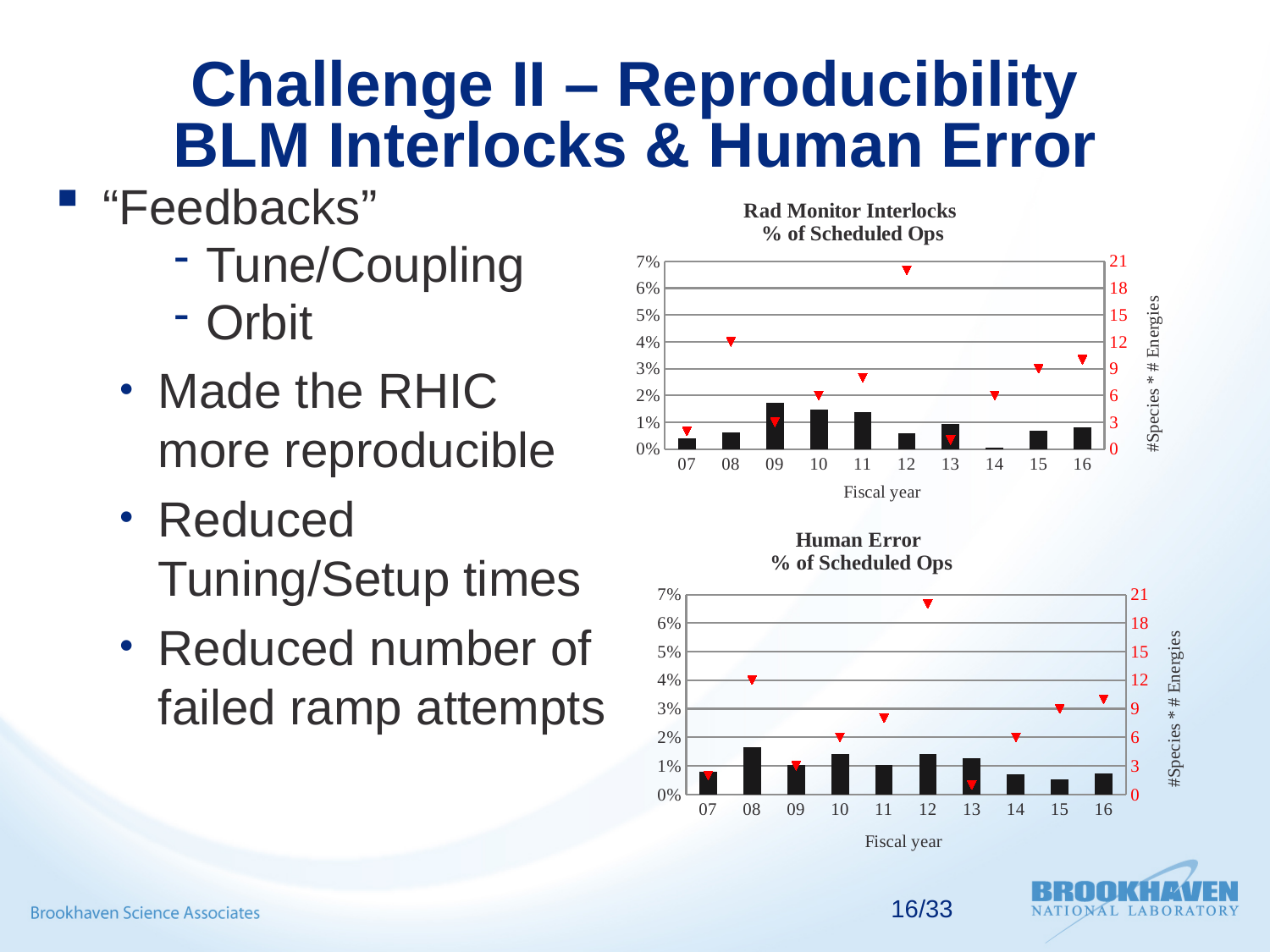
In the 'Human Error % of Scheduled Ops' chart, which fiscal year has the tallest bar? 08 In the 'Rad Monitor Interlocks % of Scheduled Ops' chart, which fiscal year has the shortest bar? 14 In the 'Rad Monitor Interlocks % of Scheduled Ops' chart, which fiscal year has the highest red triangle marker (#Species * # Energies)? 12 In the 'Human Error % of Scheduled Ops' chart, which bar is taller: fiscal year 08 or fiscal year 15? 08 What is the label of the right-hand vertical axis on the 'Rad Monitor Interlocks % of Scheduled Ops' chart? #Species * # Energies In the 'Human Error % of Scheduled Ops' chart, is the red triangle marker for fiscal year 12 greater or less than 18 on the right axis? greater In the 'Human Error % of Scheduled Ops' chart, is the bar for fiscal year 15 greater or less than 1%? less How many fiscal years are shown on the x axis of the 'Human Error % of Scheduled Ops' chart? 10 In the 'Rad Monitor Interlocks % of Scheduled Ops' chart, is the bar for fiscal year 09 greater or less than 1%? greater In the 'Human Error % of Scheduled Ops' chart, which fiscal year has the shortest bar? 15 What kind of chart is the 'Rad Monitor Interlocks % of Scheduled Ops' chart? Bar chart In the 'Rad Monitor Interlocks % of Scheduled Ops' chart, which fiscal year has the tallest bar? 09